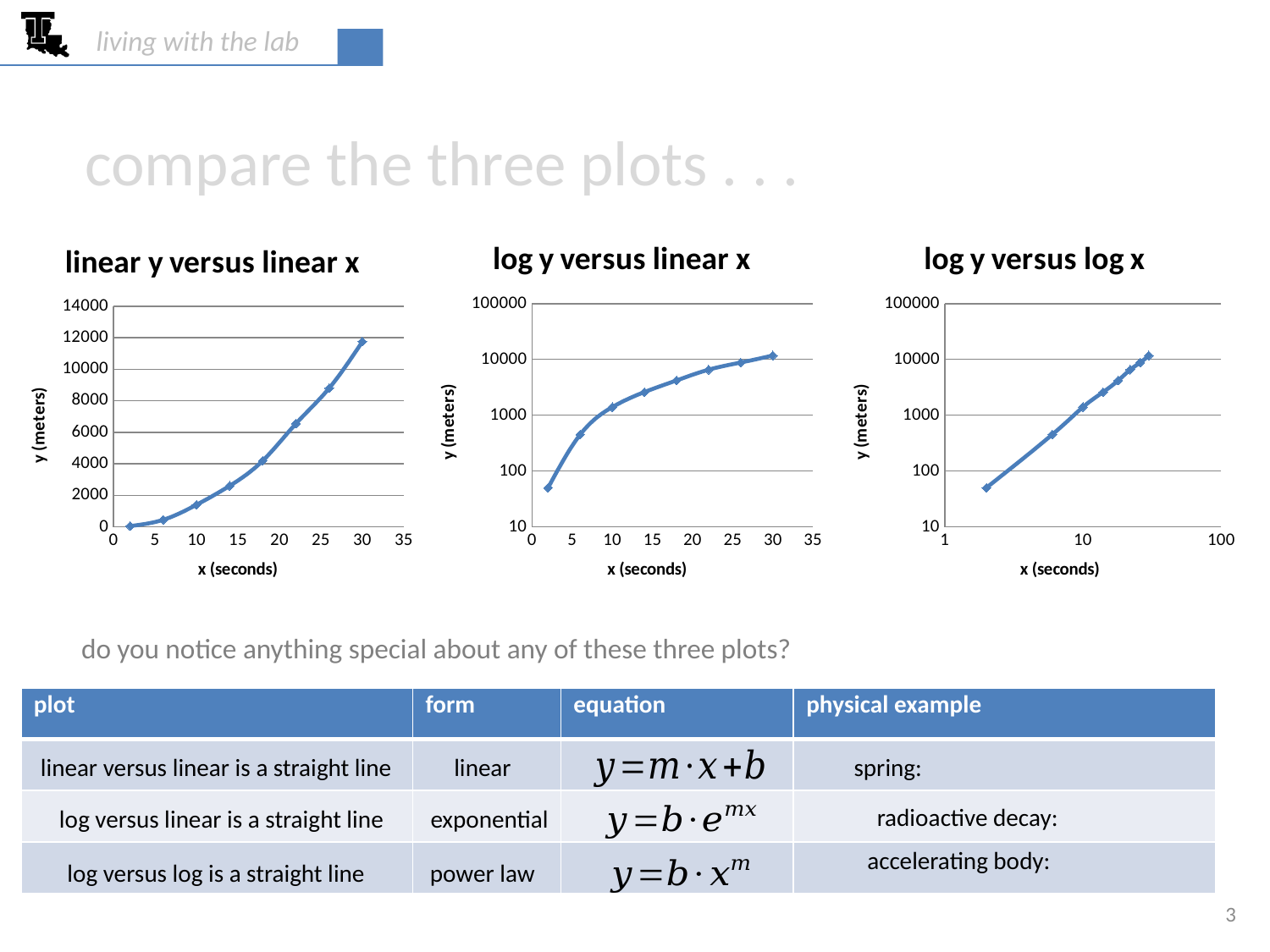
In the 'linear y versus linear x' chart, do the y values rise or fall as x increases? rise In the 'linear y versus linear x' chart, is the value at x = 30 greater or less than 10000? greater What kind of chart is the 'linear y versus linear x' chart? line chart In the 'log y versus linear x' chart, is the value at x = 10 greater or less than 1000? greater In the 'linear y versus linear x' chart, is the value at x = 10 greater or less than 2000? less What is the y-axis title of the 'log y versus log x' chart? y (meters) How many charts are shown on the slide? 3 In the 'log y versus log x' chart, do the y values rise or fall as x increases? rise In the 'linear y versus linear x' chart, at which x value (in seconds) is y highest? 30 In the 'linear y versus linear x' chart, how many data points are plotted? 8 What is the title of the middle chart on the slide? log y versus linear x